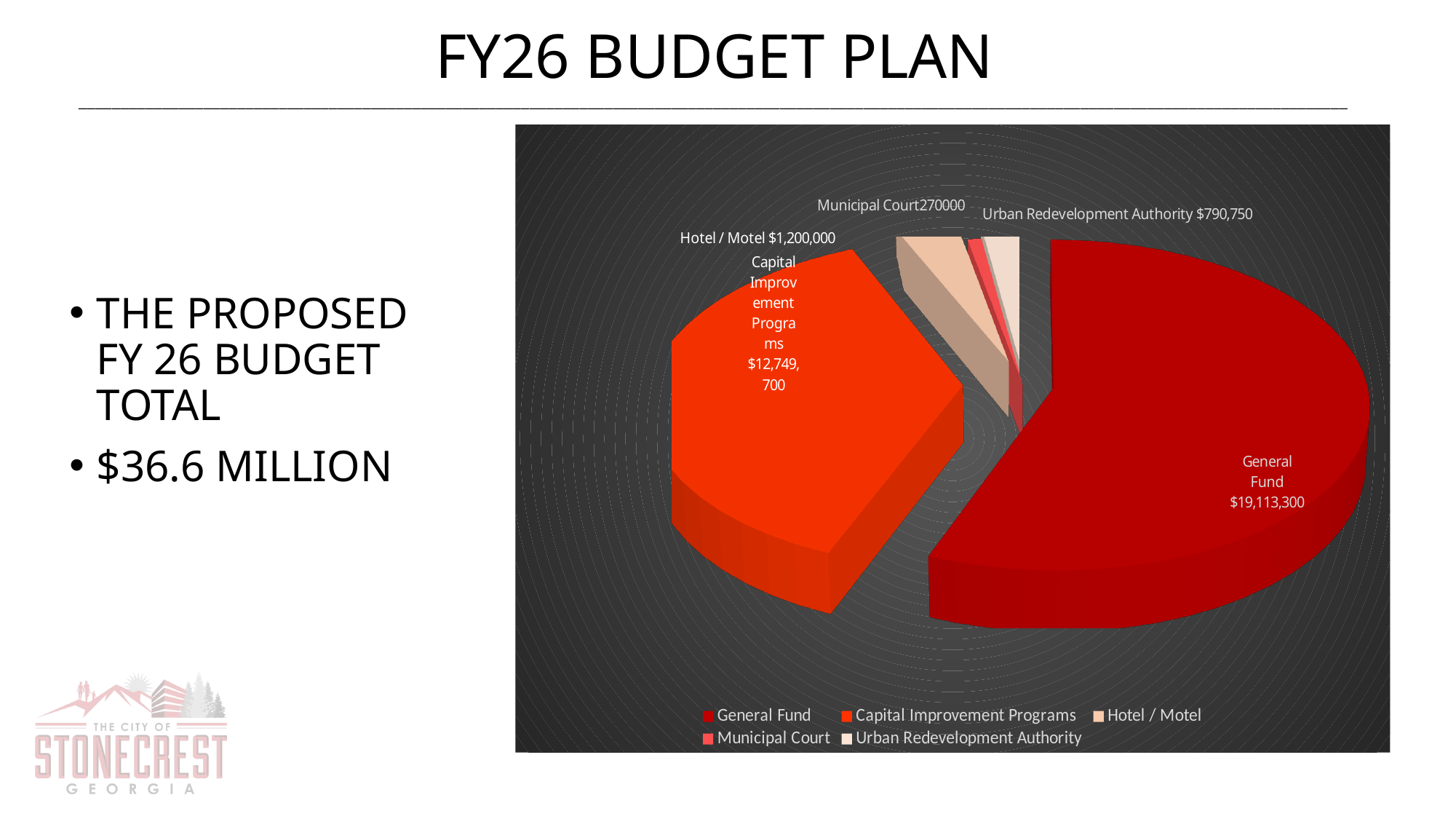
What type of chart is shown on the slide? Pie chart What is the value shown for Capital Improvement Programs? $12,749,700 Which is larger, Hotel / Motel or Urban Redevelopment Authority? Hotel / Motel What is the value shown for the General Fund slice? $19,113,300 How much larger is the General Fund than Capital Improvement Programs? $6,363,600 What is the value shown for Hotel / Motel? $1,200,000 Which category has the largest slice of the pie? General Fund How many categories does the legend list? 5 What value is labelled for Municipal Court? 270000 What is the difference between Hotel / Motel and the Urban Redevelopment Authority? $409,250 What is the value shown for the Urban Redevelopment Authority? $790,750 Which category has the smallest slice of the pie? Municipal Court